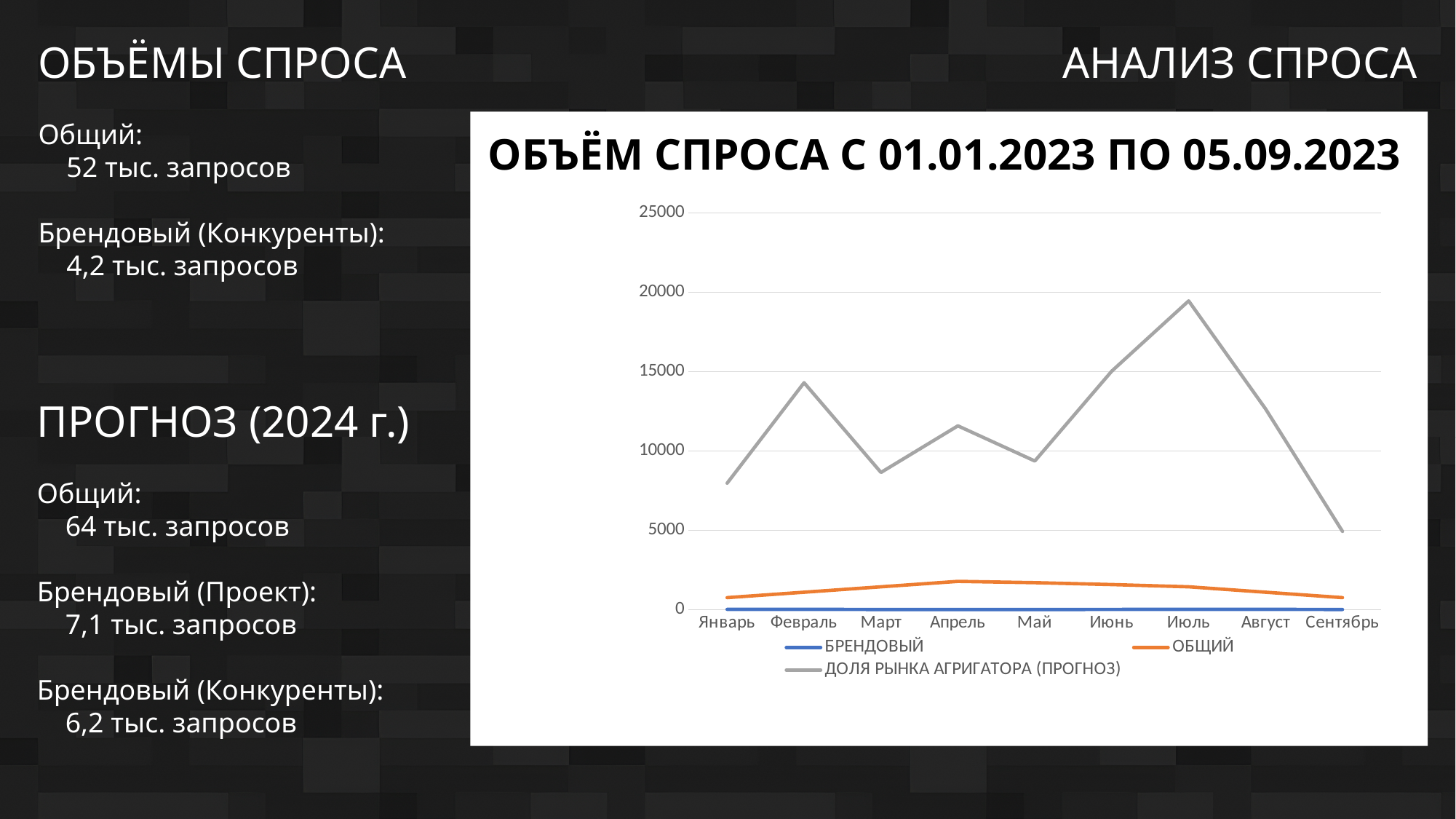
In which month does the ОБЩИЙ series reach its highest value? Апрель Is the value of ДОЛЯ РЫНКА АГРИГАТОРА (ПРОГНОЗ) for Март greater or less than 10000? less Which month has the larger value for ДОЛЯ РЫНКА АГРИГАТОРА (ПРОГНОЗ), Февраль or Март? Февраль What kind of chart is shown on the slide? line chart Is the value of ДОЛЯ РЫНКА АГРИГАТОРА (ПРОГНОЗ) for Февраль greater or less than 10000? greater In which month does the ДОЛЯ РЫНКА АГРИГАТОРА (ПРОГНОЗ) series reach its lowest value? Сентябрь Is the value of ДОЛЯ РЫНКА АГРИГАТОРА (ПРОГНОЗ) for Июль greater or less than 15000? greater Does the ДОЛЯ РЫНКА АГРИГАТОРА (ПРОГНОЗ) series rise or fall from Июль to Сентябрь? fall How many months are plotted along the x axis of the chart? 9 In which month does the ДОЛЯ РЫНКА АГРИГАТОРА (ПРОГНОЗ) series reach its highest value? Июль How many series does the chart legend list? 3 What is the title of the chart? ОБЪЁМ СПРОСА С 01.01.2023 ПО 05.09.2023